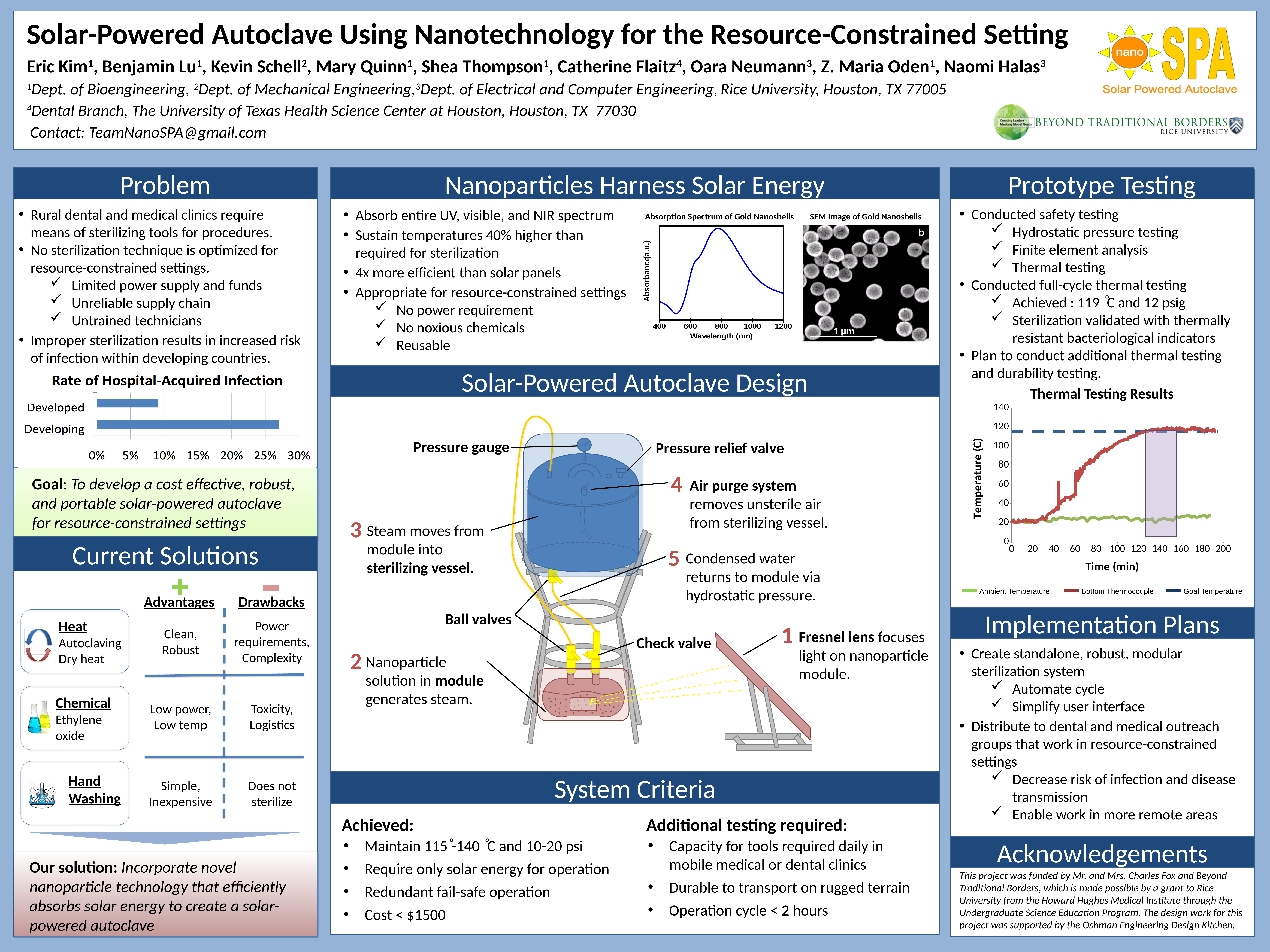
How many categories are shown in the 'Rate of Hospital-Acquired Infection' chart? 2 In the 'Thermal Testing Results' chart, does the Bottom Thermocouple temperature rise or fall over time? rise What is the x-axis label of the 'Thermal Testing Results' chart? Time (min) In the 'Thermal Testing Results' chart, is the Bottom Thermocouple temperature at 180 min greater or less than 100? greater What is the x-axis label of the 'Absorption Spectrum of Gold Nanoshells' chart? Wavelength (nm) How many series does the legend of the 'Thermal Testing Results' chart list? 3 In the 'Thermal Testing Results' chart, is the Ambient Temperature at 100 min greater or less than 40? less What kind of chart is the 'Rate of Hospital-Acquired Infection' chart? bar chart In the 'Rate of Hospital-Acquired Infection' chart, which category has the lower rate? Developed In the 'Rate of Hospital-Acquired Infection' chart, which category has the higher rate? Developing In the 'Rate of Hospital-Acquired Infection' chart, is the value for Developing greater or less than 25%? greater